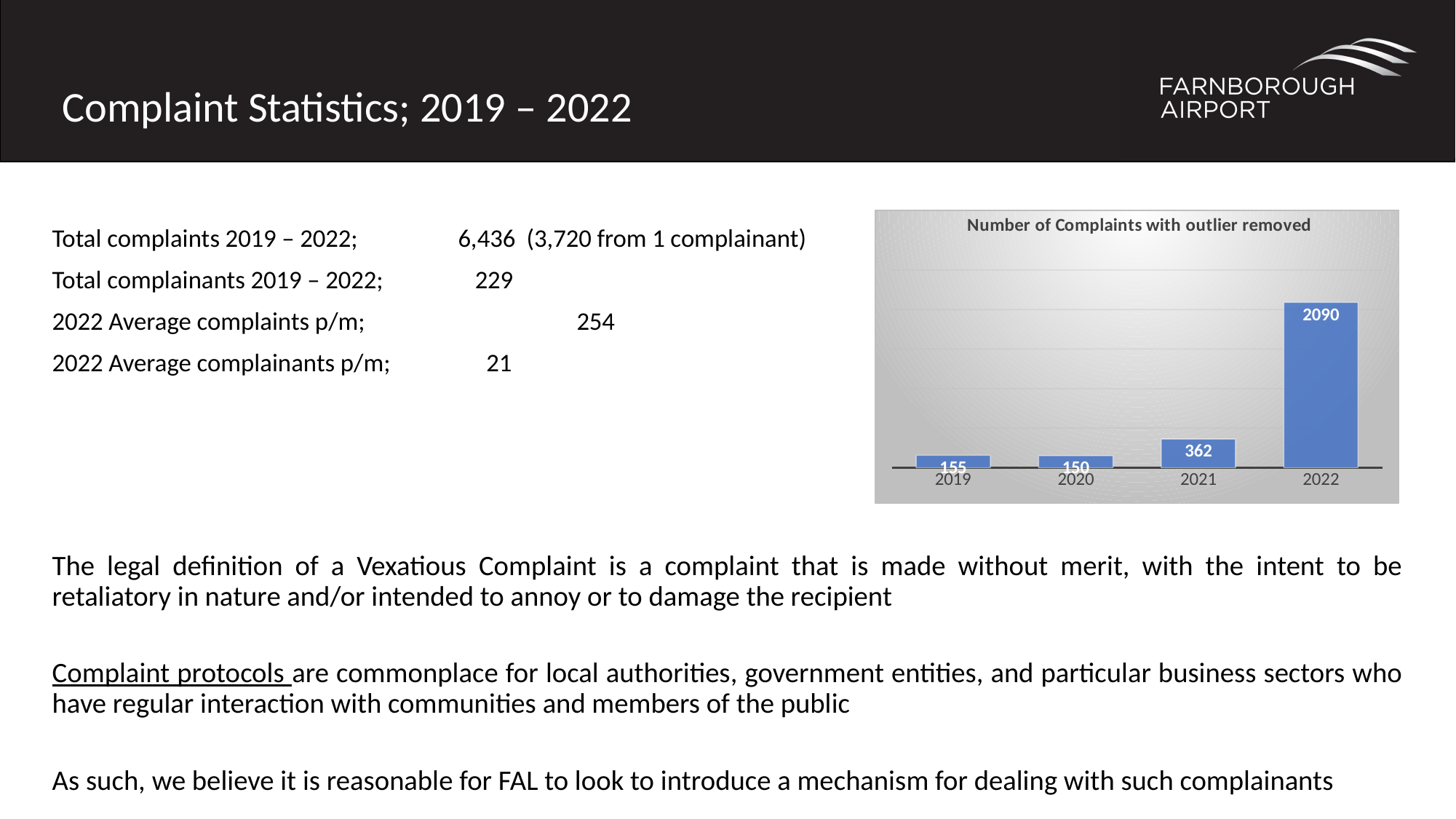
What is the title of the chart on the slide? Number of Complaints with outlier removed Which year has the lowest number of complaints in the chart? 2020 What is the number of complaints shown for 2020 in the chart? 150 What is the difference between the number of complaints in 2021 and 2019? 207 What is the difference between the number of complaints in 2022 and 2021? 1728 How many years are shown on the x axis of the chart? 4 What is the number of complaints shown for 2022 in the chart? 2090 Which year has more complaints, 2021 or 2020? 2021 What kind of chart is shown on the slide? Bar chart What is the number of complaints shown for 2019 in the chart? 155 What is the number of complaints shown for 2021 in the chart? 362 Which year has the highest number of complaints in the chart? 2022